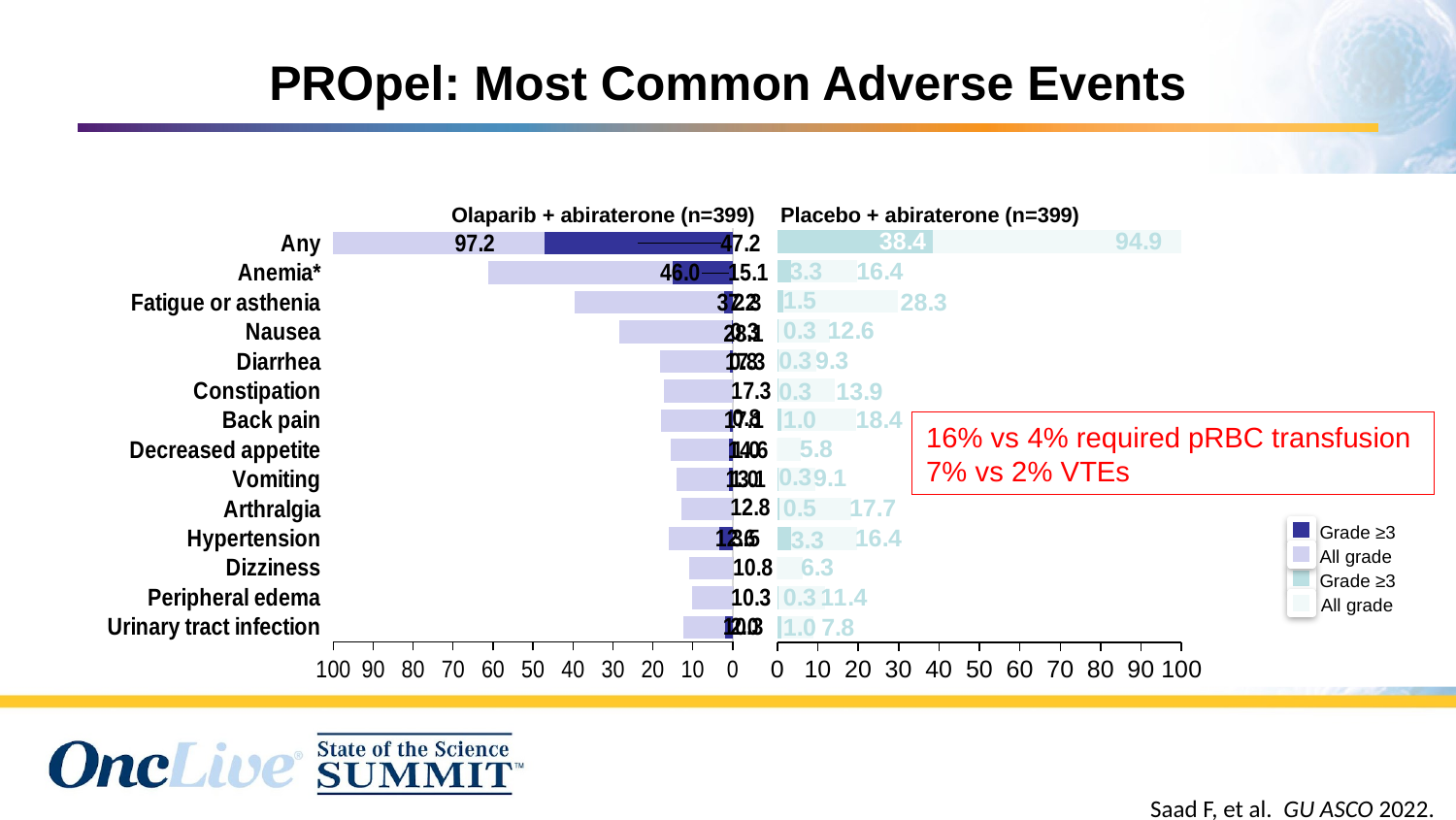
Excluding 'Any', which adverse event has the highest all-grade rate in the Olaparib + abiraterone arm? Anemia* Which arm has the higher all-grade anemia rate, Olaparib + abiraterone or Placebo + abiraterone? Olaparib + abiraterone What is the Grade ≥3 rate of any adverse event in the Placebo + abiraterone arm? 38.4 What is the all-grade rate of fatigue or asthenia in the Placebo + abiraterone arm? 28.3 How many adverse event categories are listed on the chart? 14 What is the difference between the Grade ≥3 'Any' adverse event rates of the Olaparib + abiraterone and Placebo + abiraterone arms? 8.8 How many entries does the chart legend list? 4 What is the all-grade back pain rate in the Placebo + abiraterone arm? 18.4 What is the difference between the all-grade 'Any' adverse event rates of the Olaparib + abiraterone and Placebo + abiraterone arms? 2.3 What is the all-grade anemia rate in the Olaparib + abiraterone arm? 46.0 What type of chart is shown on the slide? Bar chart What is the all-grade rate of any adverse event in the Olaparib + abiraterone arm? 97.2